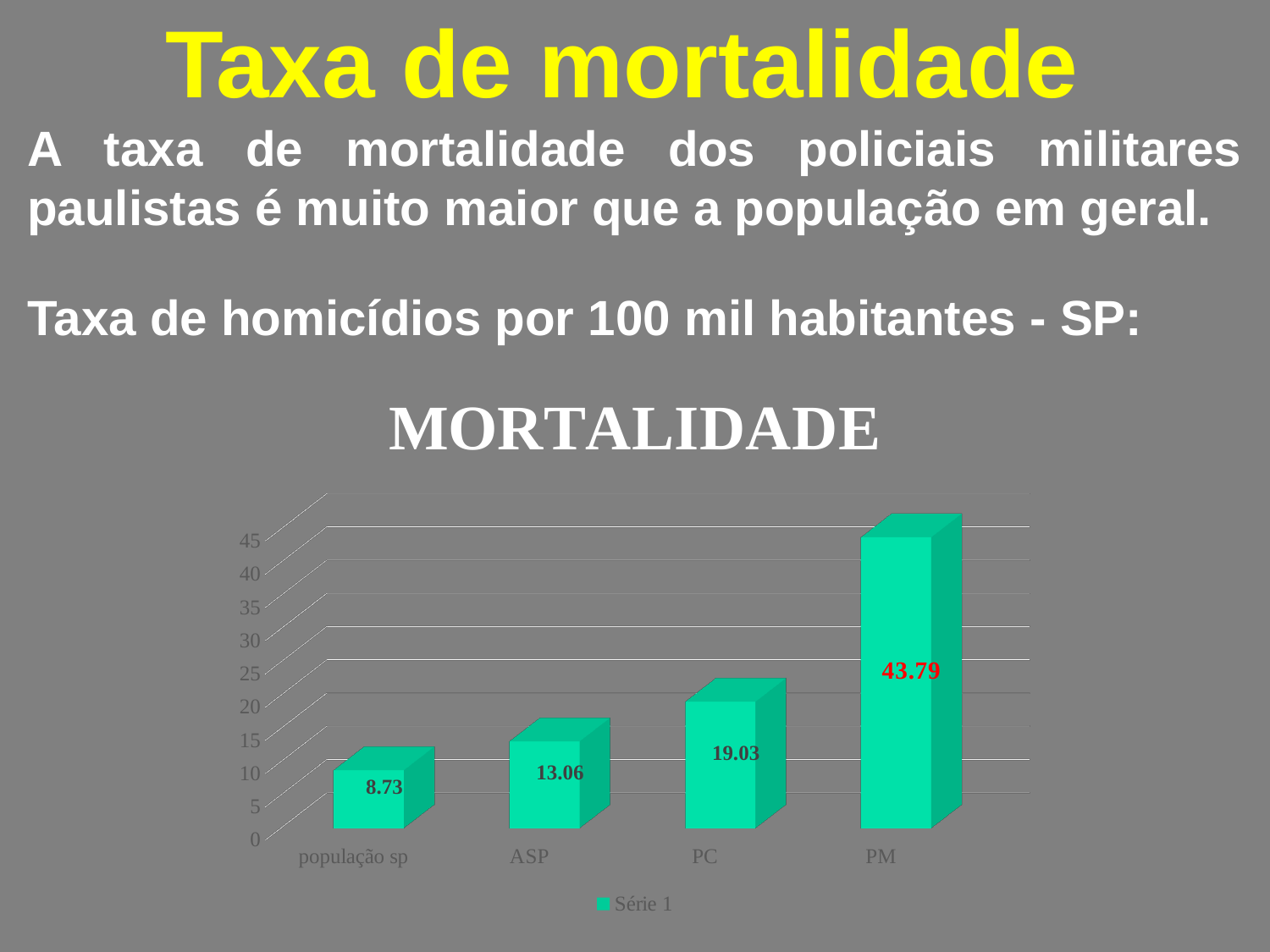
Which category has the highest value? PM What is the title of the chart? MORTALIDADE What is the value for ASP? 13.06 Is the value for PM greater or less than 40? greater What kind of chart is shown? bar chart What is the value for PC? 19.03 What is the value for PM? 43.79 What is the difference between the values for PM and população sp? 35.06 Which category has the lowest value? população sp Which is larger, the value for PC or the value for ASP? PC How many categories are shown on the x axis? 4 What is the value for população sp? 8.73